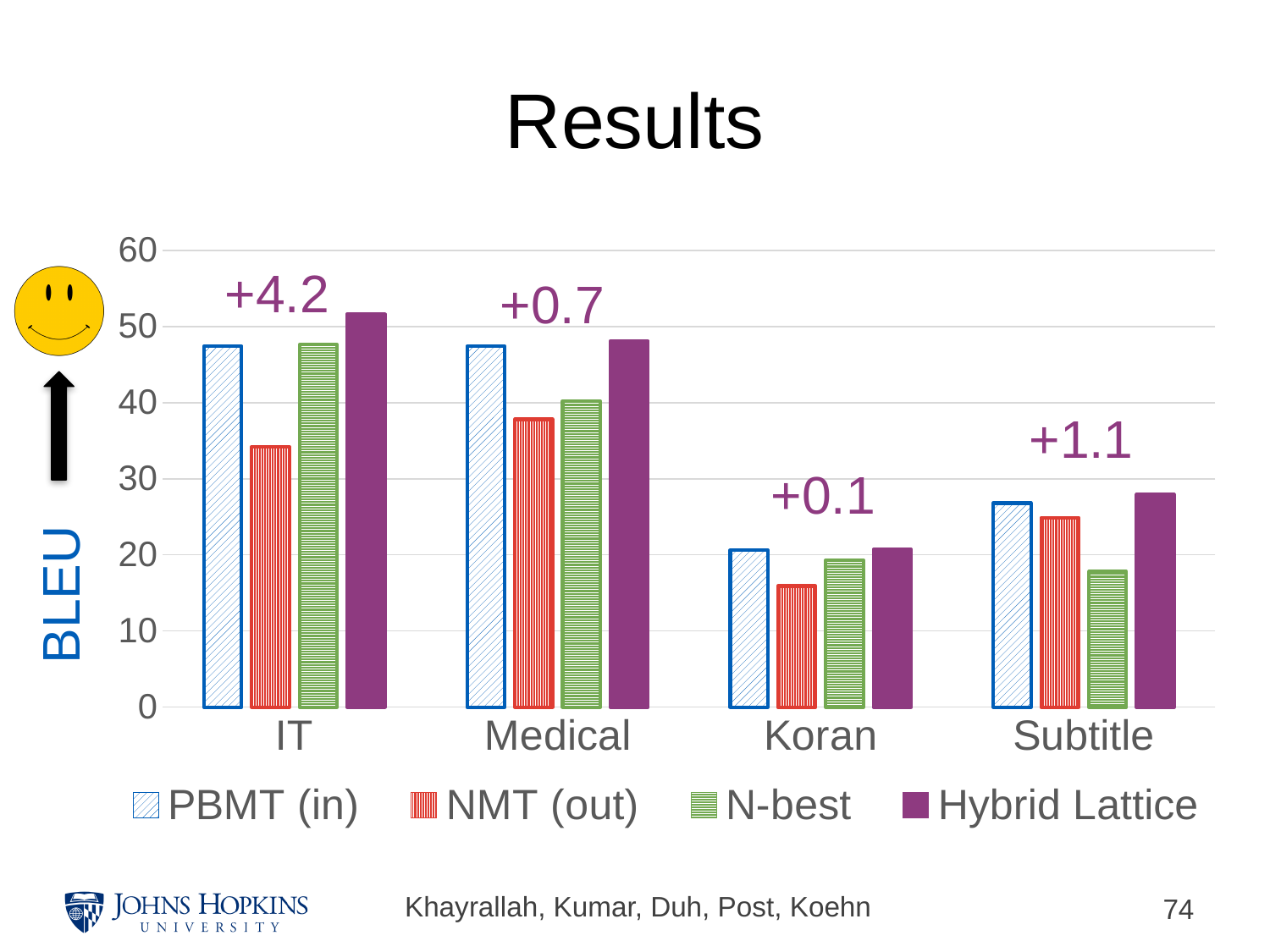
Which is larger: the PBMT (in) value for Koran or the PBMT (in) value for Subtitle? Subtitle Within the IT category, which series has the lowest bar? NMT (out) Is the Hybrid Lattice value for Subtitle greater or less than 30? less Is the Hybrid Lattice value for IT greater or less than 50? greater What improvement is annotated above the IT group of bars? +4.2 Is the NMT (out) value for Koran greater or less than 20? less Which category has the highest Hybrid Lattice bar? IT What kind of chart is shown on the slide? bar chart How many series does the chart's legend list? 4 What is the label on the y axis of the chart? BLEU How many categories are shown on the x axis of the chart? 4 Which category has the lowest NMT (out) bar? Koran